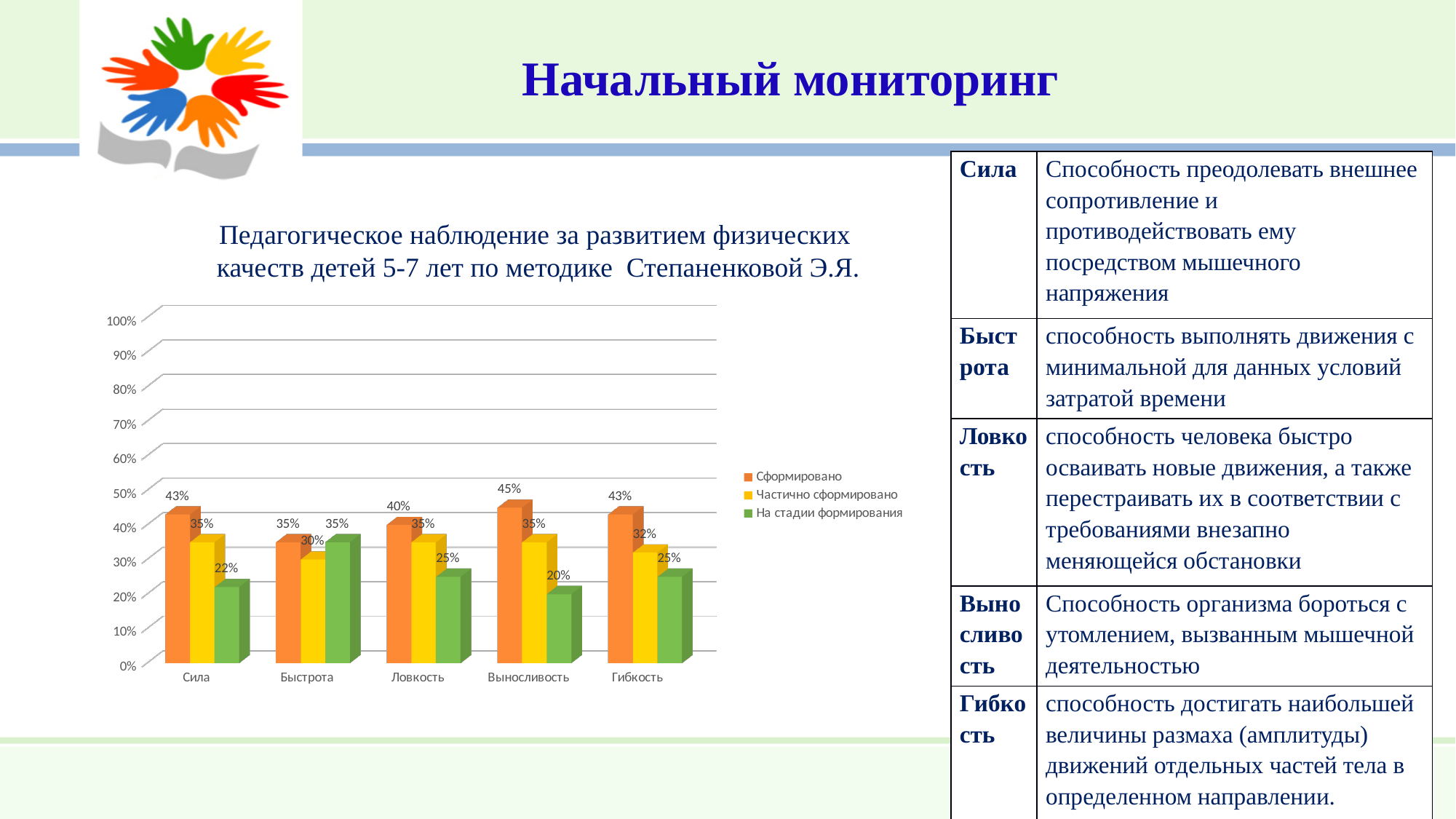
What kind of chart is shown on the slide? Bar chart How many categories are shown on the x axis? 5 Which category has the highest value for Сформировано? Выносливость Which is larger: the На стадии формирования value for Быстрота or for Гибкость? Быстрота What value is shown for Сформировано in the Выносливость category? 45% Which category has the lowest value for На стадии формирования? Выносливость What value is shown for Сформировано in the Быстрота category? 35% Which colour represents the Частично сформировано series? Yellow How many series does the legend list? 3 What is the difference between the Сформировано values for Выносливость and Ловкость? 5% What value is shown for На стадии формирования in the Сила category? 22% What value is shown for Частично сформировано in the Гибкость category? 32%